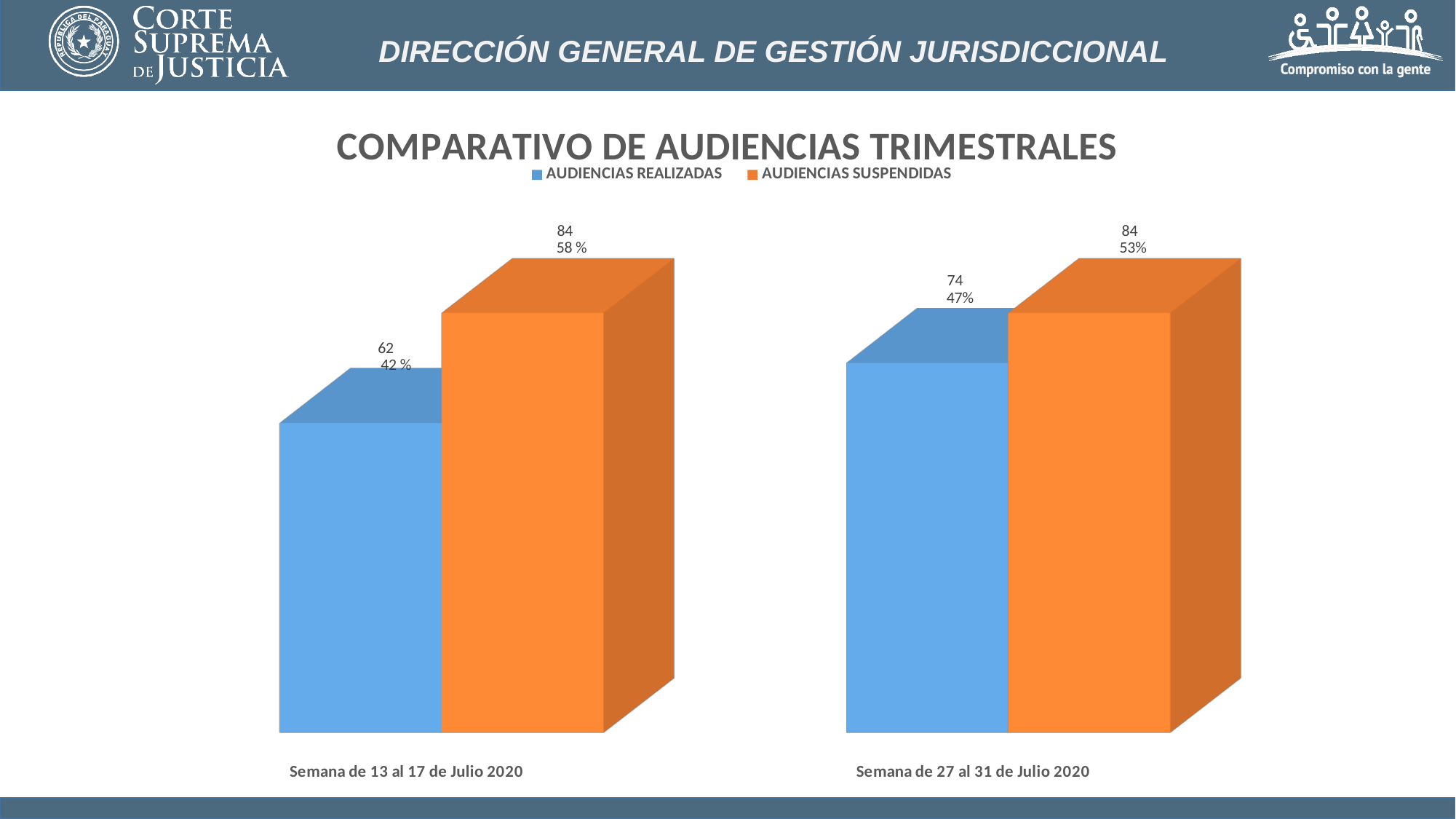
What is the difference between AUDIENCIAS SUSPENDIDAS and AUDIENCIAS REALIZADAS for Semana de 27 al 31 de Julio 2020? 10 How many series does the legend list? 2 What kind of chart is shown on the slide? Bar chart Which series has the higher value in Semana de 13 al 17 de Julio 2020? AUDIENCIAS SUSPENDIDAS What percentage is shown for AUDIENCIAS REALIZADAS in Semana de 27 al 31 de Julio 2020? 47% In which week was the value of AUDIENCIAS REALIZADAS higher? Semana de 27 al 31 de Julio 2020 What is the value of AUDIENCIAS SUSPENDIDAS for Semana de 27 al 31 de Julio 2020? 84 What is the difference between AUDIENCIAS SUSPENDIDAS and AUDIENCIAS REALIZADAS for Semana de 13 al 17 de Julio 2020? 22 What is the title of the chart? COMPARATIVO DE AUDIENCIAS TRIMESTRALES What percentage is shown for AUDIENCIAS SUSPENDIDAS in Semana de 13 al 17 de Julio 2020? 58 % What is the value of AUDIENCIAS REALIZADAS for Semana de 13 al 17 de Julio 2020? 62 How many categories (weeks) are shown on the x axis? 2